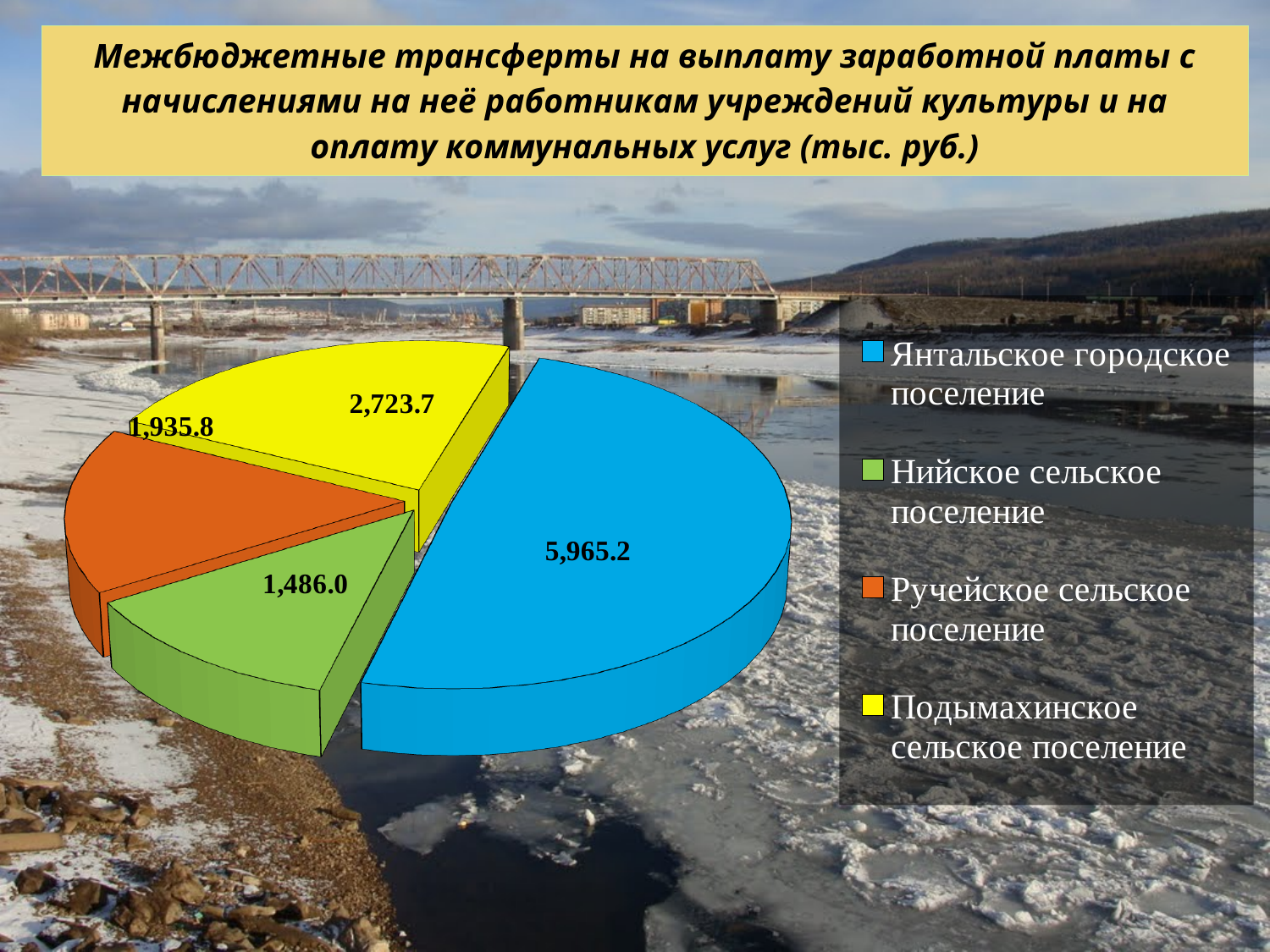
What type of chart is shown on the slide? Pie chart Which settlement has the smallest value in the pie chart? Нийское сельское поселение Which colour represents Ручейское сельское поселение in the legend? Orange What is the difference between the values for Янтальское городское поселение and Подымахинское сельское поселение? 3,241.5 What is the difference between the values for Ручейское сельское поселение and Нийское сельское поселение? 449.8 Which settlement has the largest value in the pie chart? Янтальское городское поселение How many slices does the pie chart have? 4 What is the value for Подымахинское сельское поселение? 2,723.7 What is the value for Янтальское городское поселение? 5,965.2 Which is larger: the value for Подымахинское сельское поселение or Ручейское сельское поселение? Подымахинское сельское поселение What is the value for Нийское сельское поселение? 1,486.0 What is the value for Ручейское сельское поселение? 1,935.8